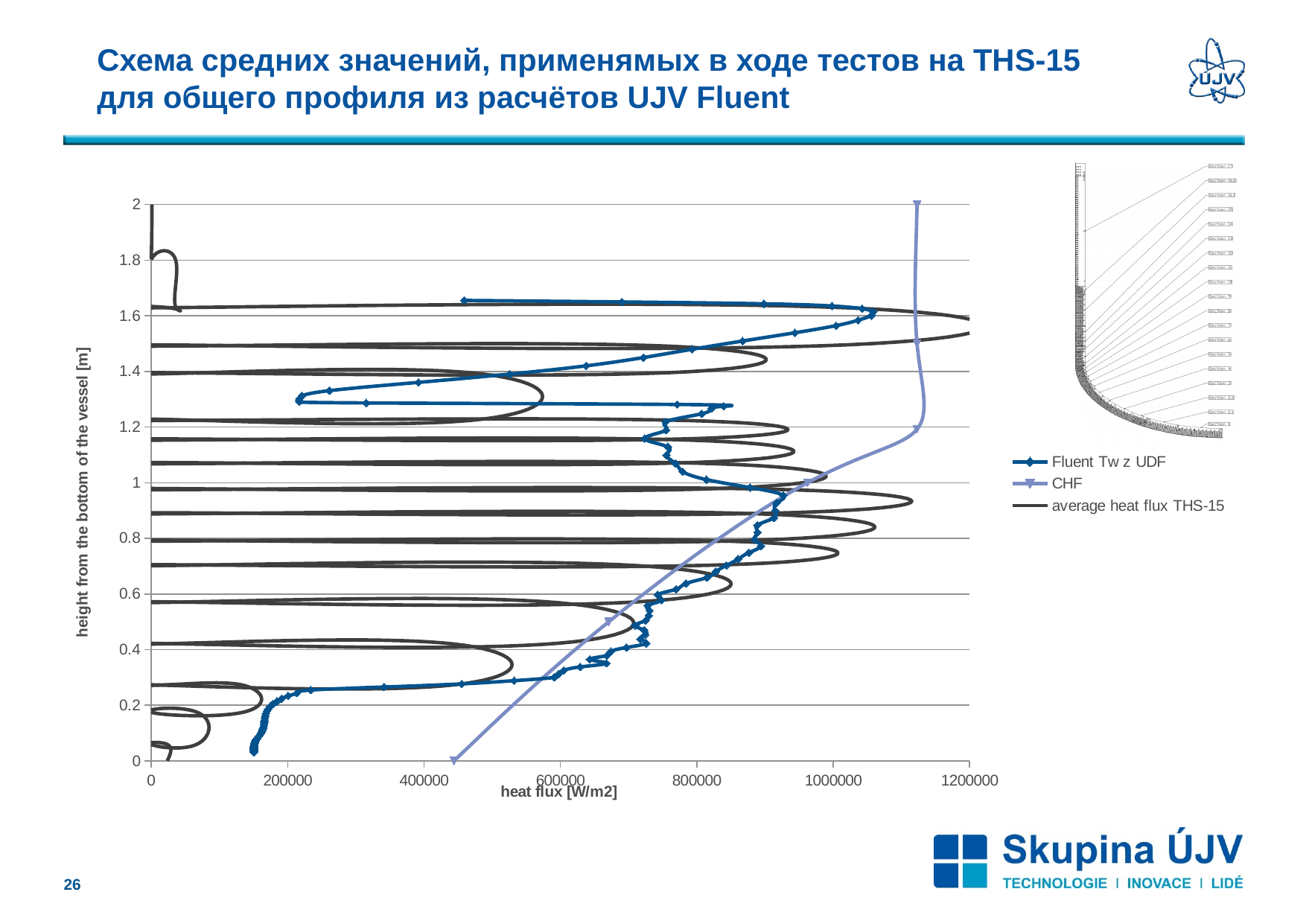
Is the heat flux of the CHF series at a height of 0 m greater or less than 600000? less What is the highest value shown on the x axis? 1200000 Is the heat flux of the Fluent Tw z UDF series at a height of 0.1 m greater or less than 200000? less What kind of chart is shown on the slide? line chart What is the label of the x axis? heat flux [W/m2] What is the label of the y axis? height from the bottom of the vessel [m] Is the heat flux of the CHF series at a height of 2 m greater or less than 1000000? greater How many series does the legend list? 3 At a height of 1.0 m, which series has the larger heat flux, CHF or Fluent Tw z UDF? CHF Does the heat flux of the CHF series increase or decrease as the height rises from 0 m to 1 m? increase